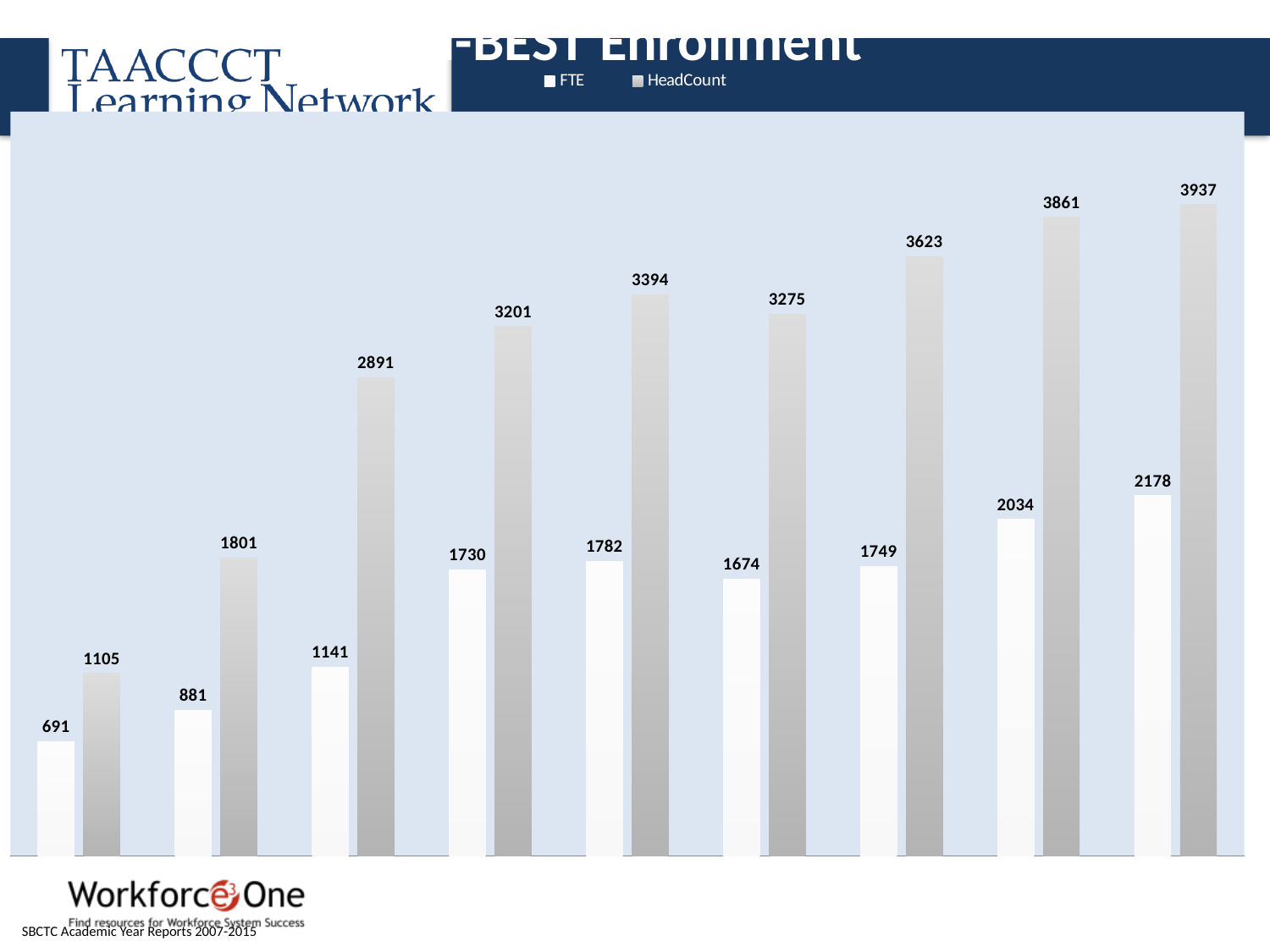
What is the HeadCount value for the last (rightmost) group of bars? 3937 What is the highest FTE value shown in the chart? 2178 What is the lowest HeadCount value shown in the chart? 1105 What kind of chart is shown on the slide? bar chart How many series does the legend list? 2 How many groups of bars are plotted in the chart? 9 In the leftmost group of bars, which is larger, the FTE value or the HeadCount value? HeadCount What is the lowest FTE value shown in the chart? 691 What is the difference between the HeadCount and FTE values in the rightmost group of bars? 1759 What are the two series named in the legend? FTE and HeadCount What is the highest HeadCount value shown in the chart? 3937 What is the FTE value for the first (leftmost) group of bars? 691